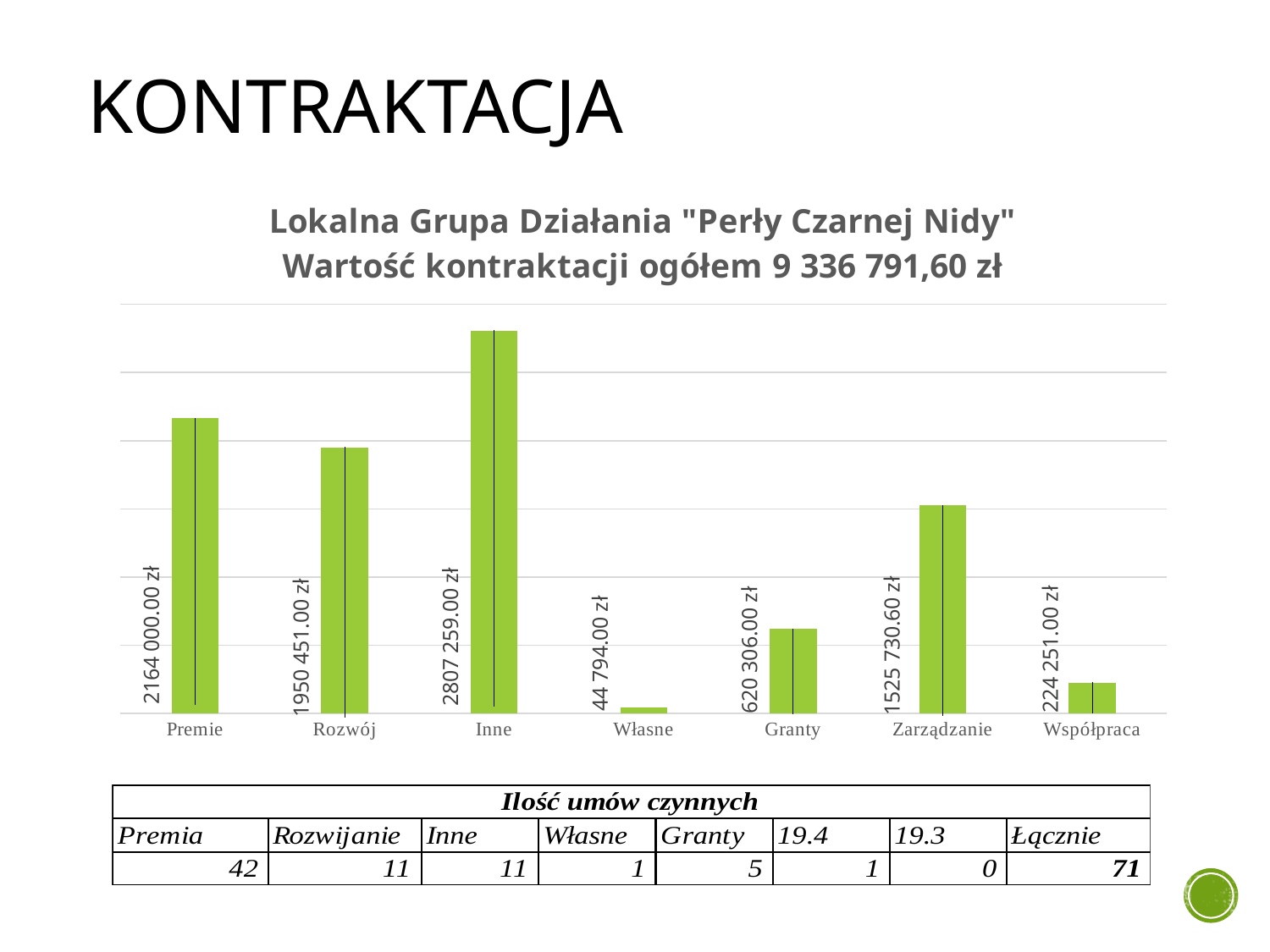
What is the value for Zarządzanie in the chart? 1525 730.60 zł What is the difference between the values for Inne and Premie? 643 259.00 zł Which category has the highest value in the chart? Inne How many categories are shown in the chart? 7 What is the difference between the values for Granty and Współpraca? 396 055.00 zł What is the value for Współpraca in the chart? 224 251.00 zł Which is larger, the value for Premie or the value for Rozwój? Premie What total contract value is stated in the chart title? 9 336 791,60 zł What is the value for Inne in the chart? 2807 259.00 zł What kind of chart is shown on the slide? Bar chart What is the value for Własne in the chart? 44 794.00 zł Which category has the lowest value in the chart? Własne